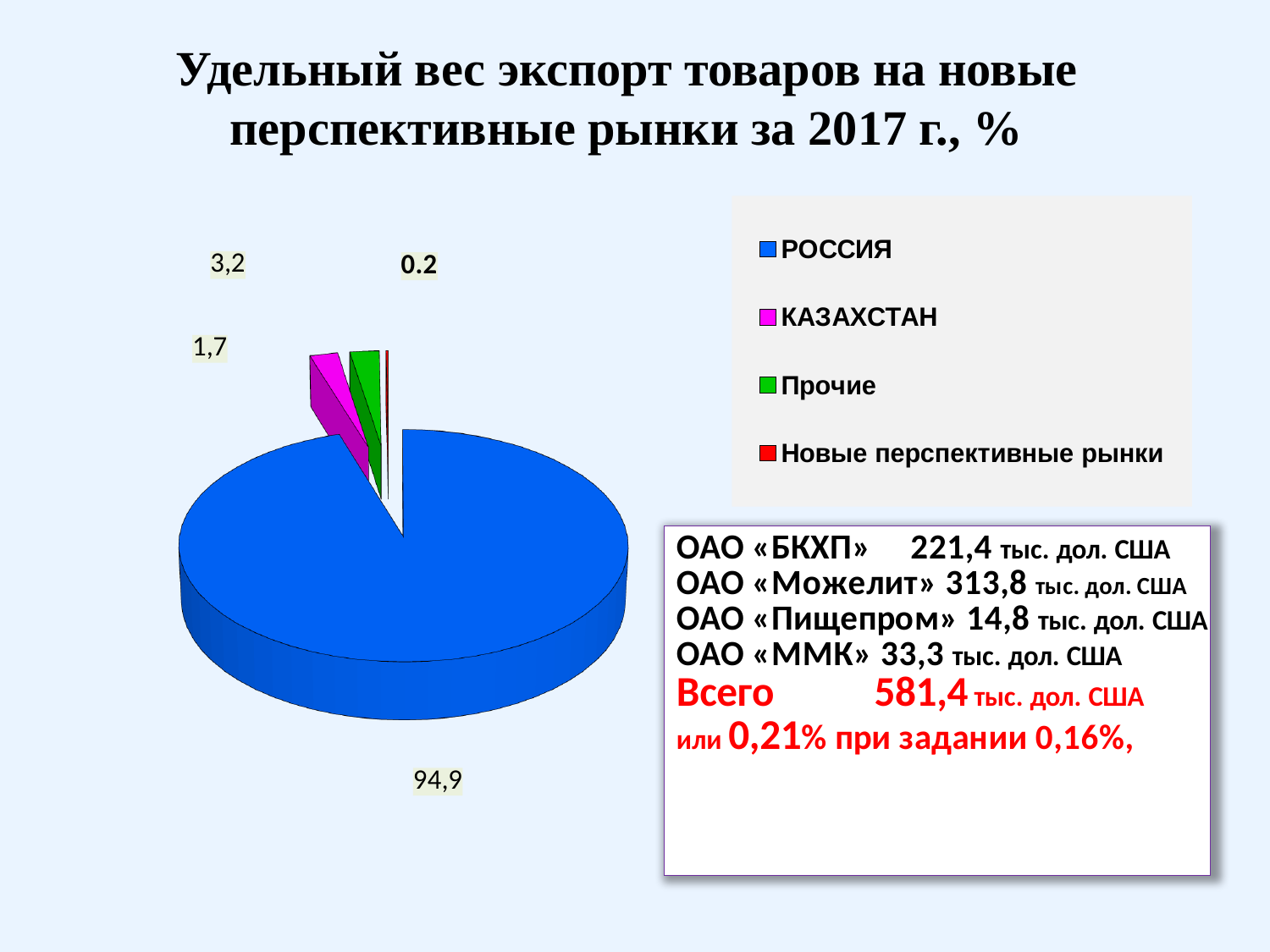
Which is larger, the share for РОССИЯ or the share for КАЗАХСТАН? РОССИЯ What kind of chart is shown on the slide? Pie chart What is the value shown for Прочие? 1,7 What year does the chart title refer to? 2017 Which category has the smallest share of the pie? Новые перспективные рынки How many entries does the chart legend list? 4 What is the value shown for Новые перспективные рынки? 0.2 What colour is the slice for РОССИЯ? Blue What is the value shown for РОССИЯ? 94,9 What is the value shown for КАЗАХСТАН? 3,2 Which category has the largest share of the pie? РОССИЯ How many slices does the pie chart have? 4